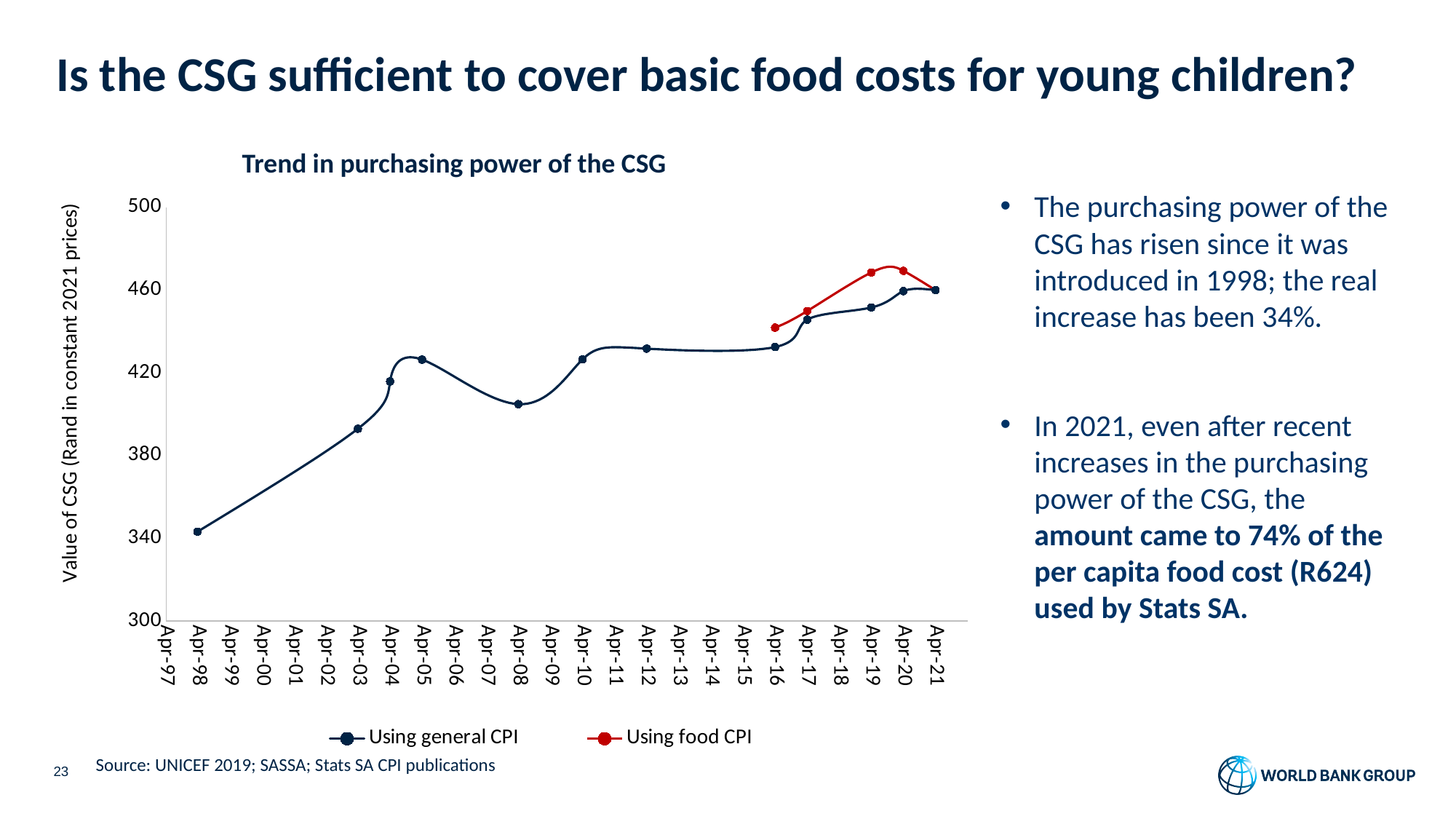
Is the 'Using general CPI' value for Apr-03 greater or less than 380? greater Is the 'Using food CPI' value for Apr-19 greater or less than 460? greater What kind of chart is shown on the slide? Line chart At Apr-19, which series has the higher value: 'Using general CPI' or 'Using food CPI'? Using food CPI What colour is the 'Using food CPI' line? Red At which date is the 'Using general CPI' value lowest? Apr-98 Is the 'Using general CPI' value for Apr-08 greater or less than 420? less What is the title of the chart? Trend in purchasing power of the CSG How many data points are plotted for the 'Using food CPI' series? 5 Does the 'Using general CPI' line rise or fall between Apr-05 and Apr-08? Fall How many series does the chart legend list? 2